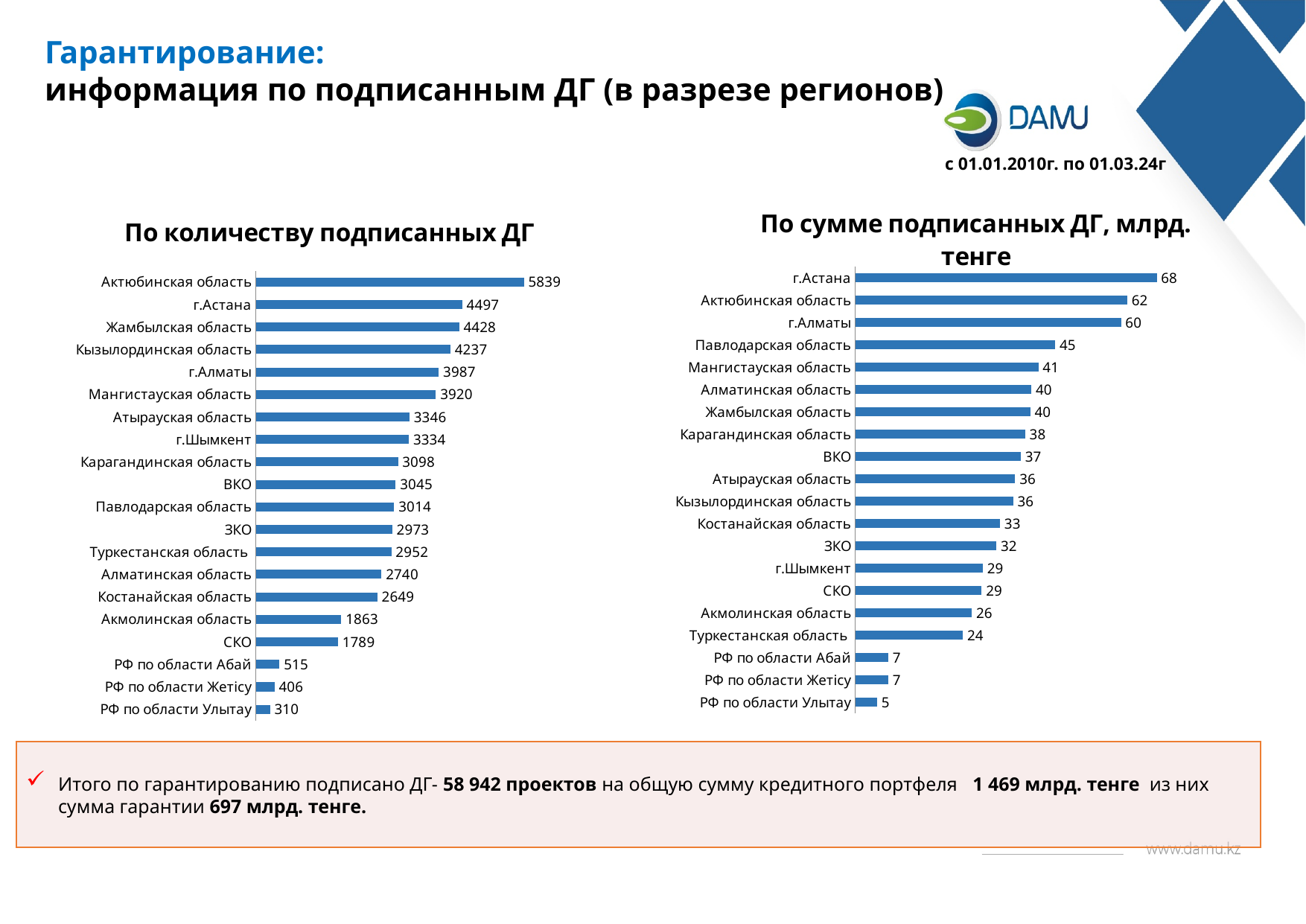
What type of chart is 'По количеству подписанных ДГ'? Bar chart On the chart 'По количеству подписанных ДГ', how many regions are shown? 20 On the chart 'По количеству подписанных ДГ', which region has the lowest value? РФ по области Улытау On the chart 'По количеству подписанных ДГ', what is the value for Кызылординская область? 4237 On the chart 'По сумме подписанных ДГ, млрд. тенге', which region has the highest value? г.Астана On the chart 'По количеству подписанных ДГ', what is the value for СКО? 1789 On the chart 'По сумме подписанных ДГ, млрд. тенге', which region has the lowest value? РФ по области Улытау On the chart 'По сумме подписанных ДГ, млрд. тенге', what is the value for Павлодарская область? 45 On the chart 'По количеству подписанных ДГ', what is the difference between г.Астана and г.Алматы? 510 On the chart 'По количеству подписанных ДГ', which region has the highest value? Актюбинская область On the chart 'По сумме подписанных ДГ, млрд. тенге', what is the difference between г.Астана and Актюбинская область? 6 On the chart 'По сумме подписанных ДГ, млрд. тенге', which is larger: Мангистауская область or Карагандинская область? Мангистауская область